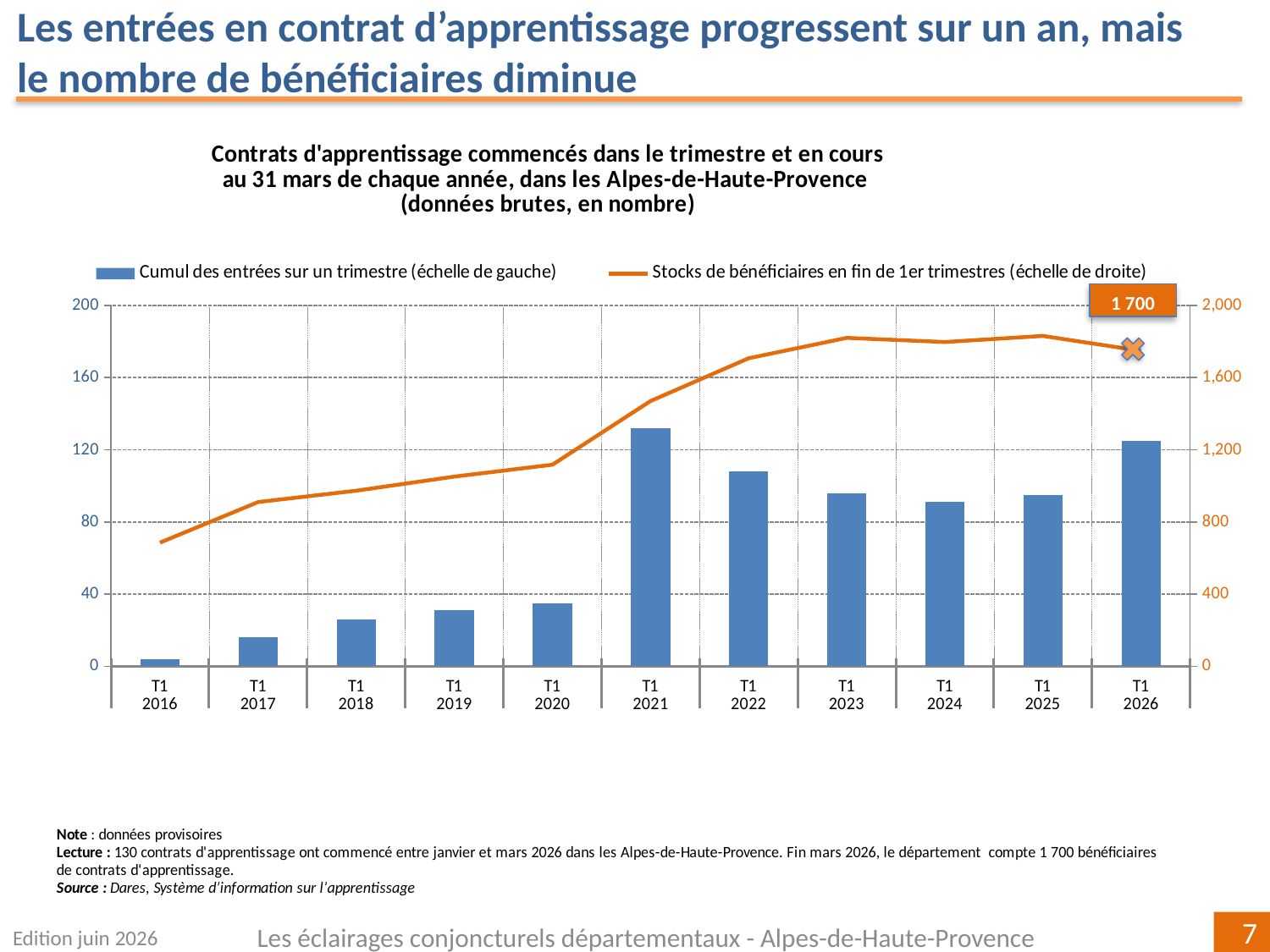
How many quarters are shown on the x axis? 11 What is the value of 'Stocks de bénéficiaires en fin de 1er trimestres' at T1 2026? 1 700 Which quarter has the lowest bar for 'Cumul des entrées sur un trimestre'? T1 2016 How many series does the legend list? 2 Which has the larger bar, T1 2022 or T1 2023? T1 2022 Which quarter has the highest bar for 'Cumul des entrées sur un trimestre'? T1 2021 Is the bar value for T1 2021 greater or less than 120? greater Is the bar value for T1 2016 greater or less than 40? less What kind of chart is this? Combined bar and line chart Is the 'Stocks de bénéficiaires' line value at T1 2016 greater or less than 800 on the right axis? less Does the 'Stocks de bénéficiaires' line rise or fall from T1 2016 to T1 2023? rise